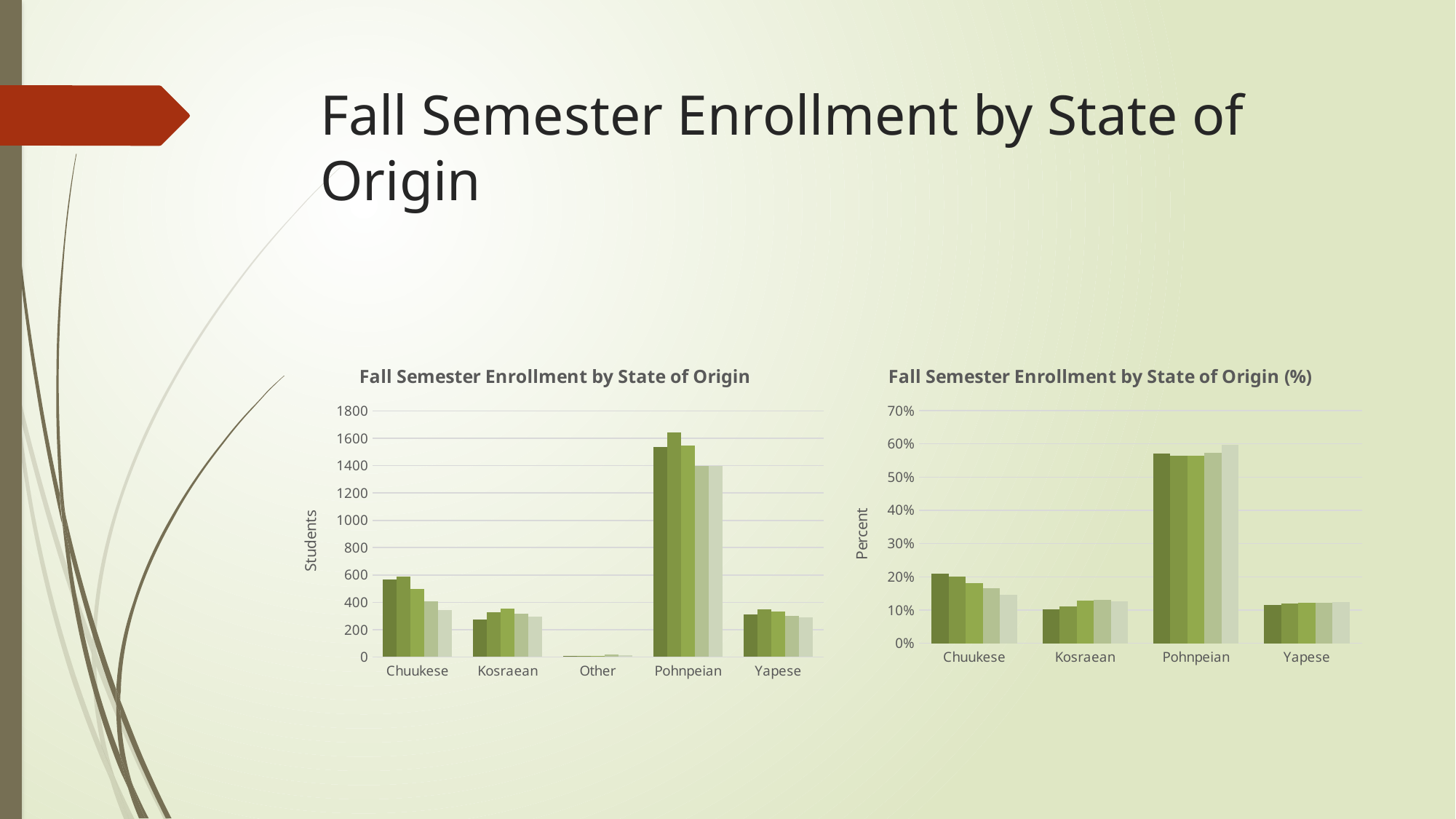
What kind of chart is the left chart, 'Fall Semester Enrollment by State of Origin'? bar chart In the left chart, 'Fall Semester Enrollment by State of Origin', which category has larger values, Pohnpeian or Yapese? Pohnpeian In the right chart, 'Fall Semester Enrollment by State of Origin (%)', are the values for Chuukese greater or less than 30%? less In the left chart, 'Fall Semester Enrollment by State of Origin', are the values for Pohnpeian greater or less than 1200? greater How many categories are shown on the x axis of the right chart, 'Fall Semester Enrollment by State of Origin (%)'? 4 In the left chart, 'Fall Semester Enrollment by State of Origin', which category has the lowest enrollment? Other In the left chart, 'Fall Semester Enrollment by State of Origin', which category has the highest enrollment? Pohnpeian How many categories are shown on the x axis of the left chart, 'Fall Semester Enrollment by State of Origin'? 5 In the right chart, 'Fall Semester Enrollment by State of Origin (%)', are the values for Pohnpeian greater or less than 50%? greater In the right chart, 'Fall Semester Enrollment by State of Origin (%)', which category has the highest percentage? Pohnpeian What is the y-axis title of the right chart, 'Fall Semester Enrollment by State of Origin (%)'? Percent